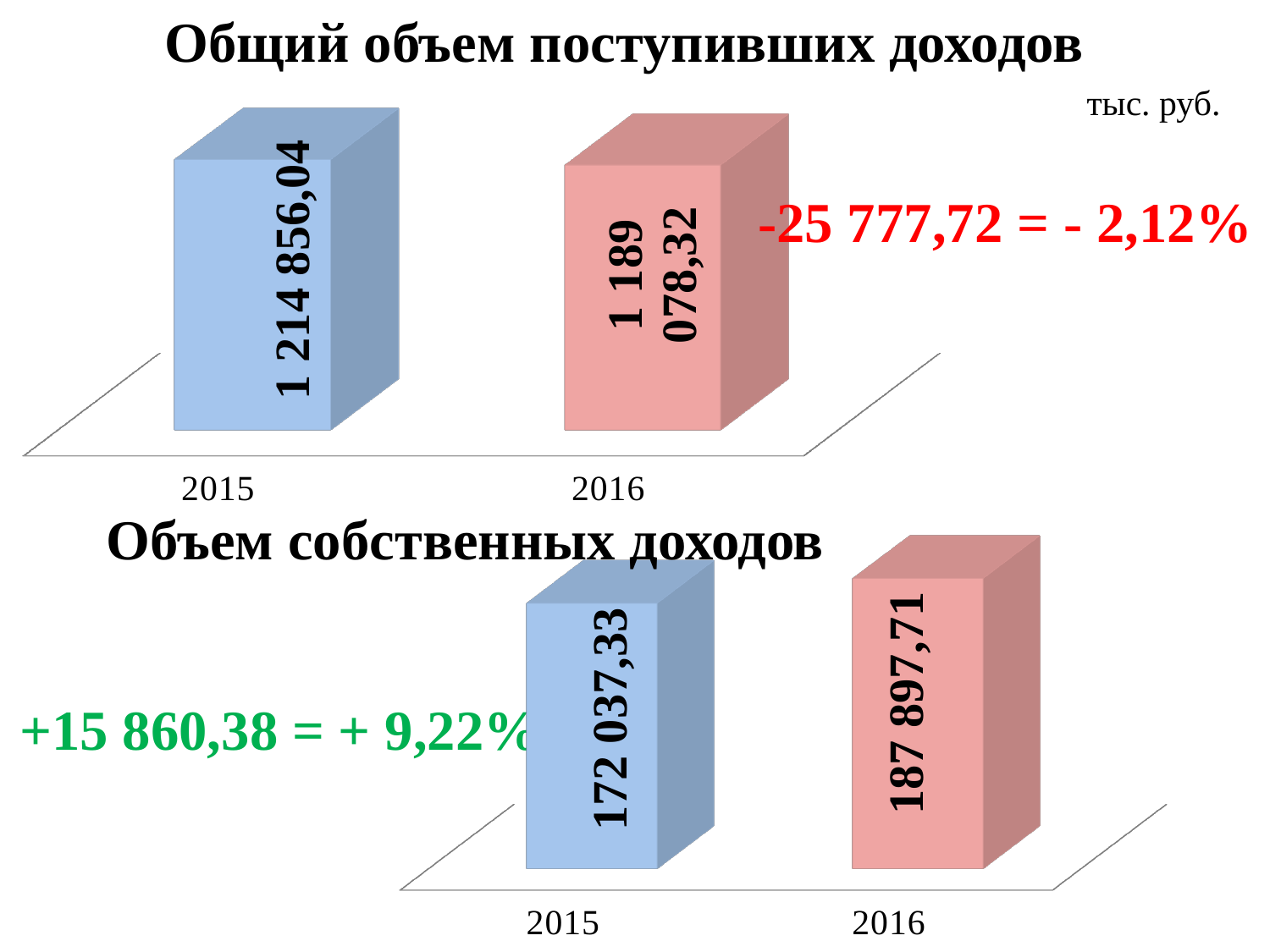
In the chart titled "Общий объем поступивших доходов", what is the value for 2016? 1 189 078,32 In the chart titled "Объем собственных доходов", which year has the lower value? 2015 In the chart titled "Общий объем поступивших доходов", what is the difference between the 2015 and 2016 values? 25 777,72 In the chart titled "Объем собственных доходов", by how much does the 2016 value exceed the 2015 value? 15 860,38 In the chart titled "Объем собственных доходов", is the value for 2016 larger or smaller than the value for 2015? larger How many bars are shown in the chart titled "Объем собственных доходов"? 2 In the chart titled "Общий объем поступивших доходов", which year has the higher value? 2015 What type of chart is the top chart on the slide? bar chart In the chart titled "Объем собственных доходов", what is the value for 2016? 187 897,71 In the chart titled "Объем собственных доходов", what is the value for 2015? 172 037,33 In the chart titled "Общий объем поступивших доходов", what is the value for 2015? 1 214 856,04 In the chart titled "Общий объем поступивших доходов", do the values rise or fall from 2015 to 2016? fall